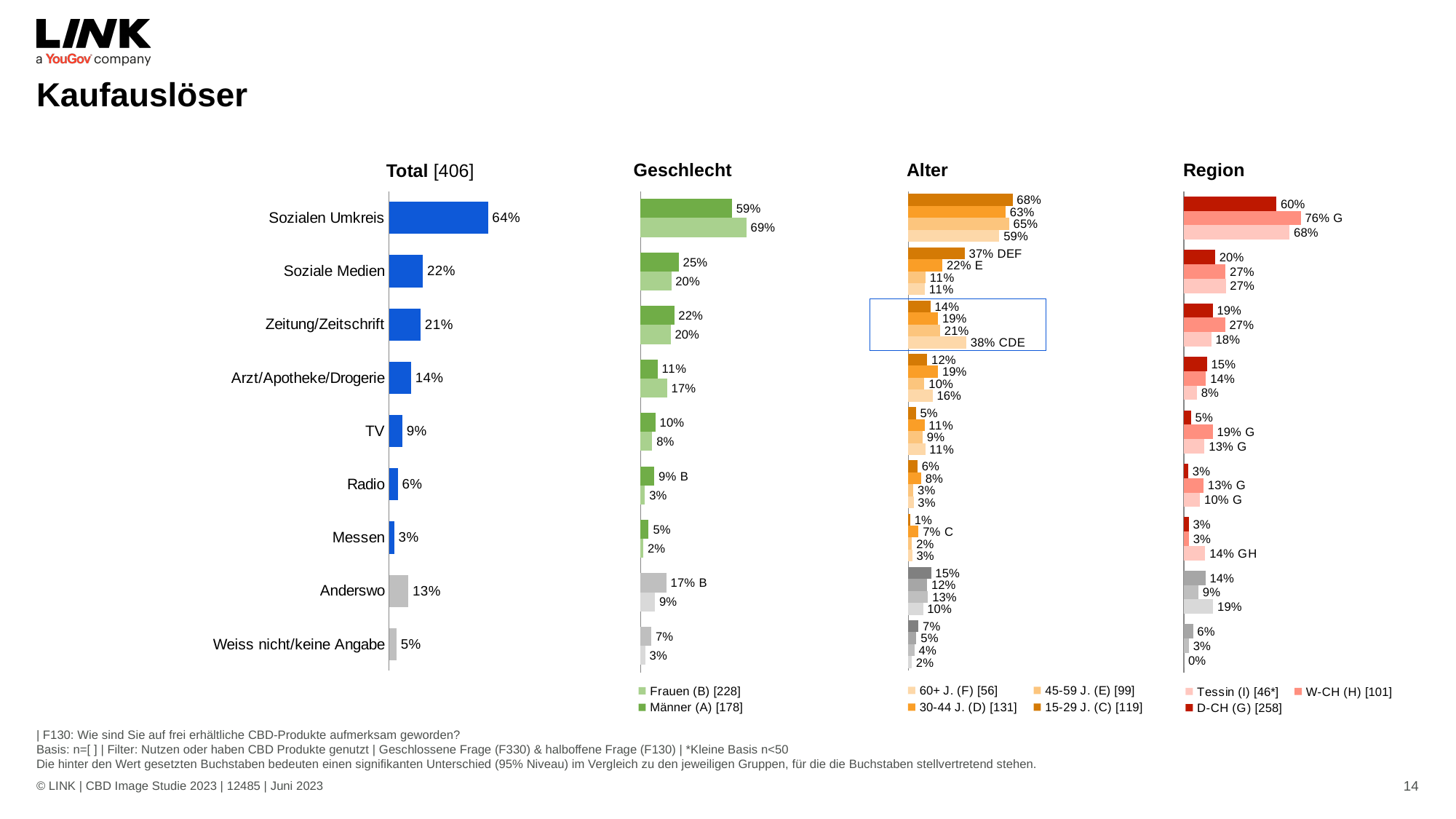
In the Geschlecht chart, which is larger for Arzt/Apotheke/Drogerie: Männer or Frauen? Frauen How many series does the legend of the Alter chart list? 4 In the Alter chart, what is the value for 60+ J. (F) for Zeitung/Zeitschrift? 38% In the Region chart, what is the value for Tessin (I) for Weiss nicht/keine Angabe? 0% What kind of chart is the Total chart? Bar chart How many categories are shown in the Total chart? 9 In the Geschlecht chart, what is the value for Frauen for Sozialen Umkreis? 69% In the Total chart, what is the difference between Soziale Medien and Zeitung/Zeitschrift? 1 percentage point In the Total chart, which category has the lowest value? Messen In the Alter chart, which age group has the highest value for Soziale Medien? 15-29 J. (C) In the Region chart, what is the value for W-CH (H) for Sozialen Umkreis? 76% In the Total chart, what is the value for Sozialen Umkreis? 64%